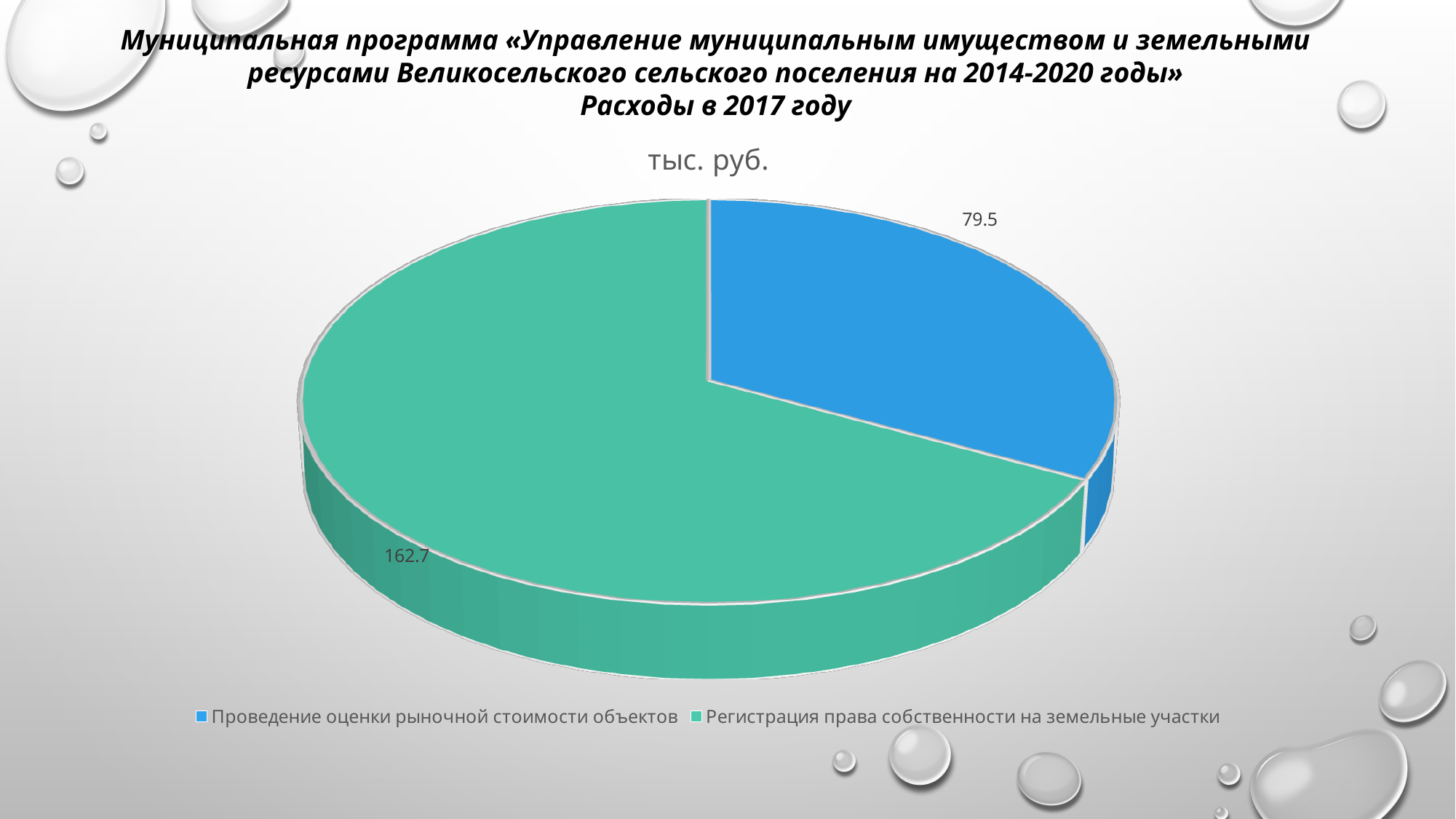
What colour is the slice for «Регистрация права собственности на земельные участки»? Green What is the total of the two values shown in the pie chart? 242.2 What is the value for «Регистрация права собственности на земельные участки»? 162.7 What type of chart is shown on the slide? Pie chart What share of the pie does «Проведение оценки рыночной стоимости объектов» represent, to the nearest percent? 33% Which category has the largest slice of the pie? Регистрация права собственности на земельные участки What is the title of the chart? тыс. руб. What is the difference between the values for «Регистрация права собственности на земельные участки» and «Проведение оценки рыночной стоимости объектов»? 83.2 Which is larger: the value for «Проведение оценки рыночной стоимости объектов» or for «Регистрация права собственности на земельные участки»? Регистрация права собственности на земельные участки Which category has the smallest slice of the pie? Проведение оценки рыночной стоимости объектов What is the value for «Проведение оценки рыночной стоимости объектов»? 79.5 How many slices does the pie chart have? 2